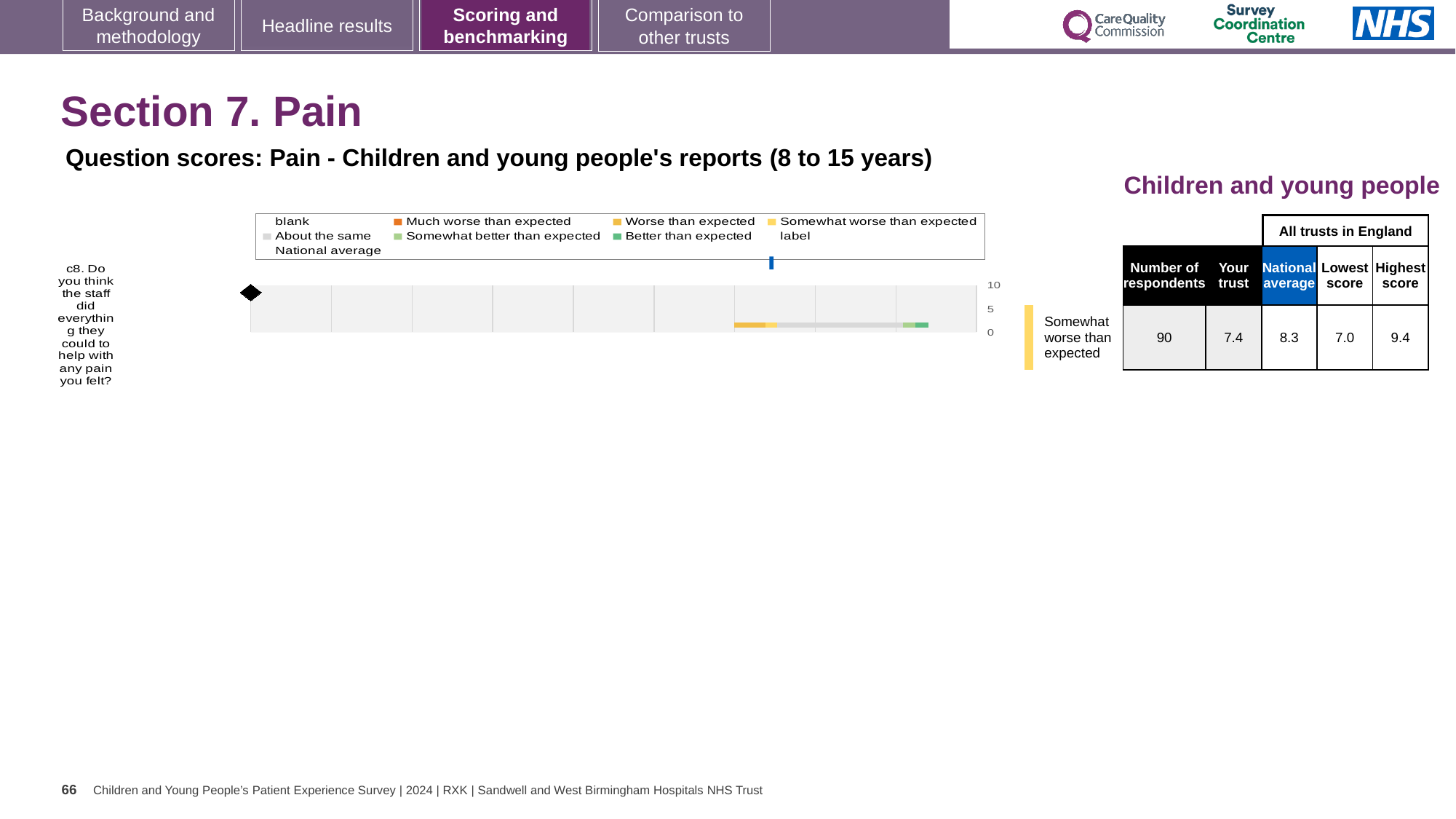
What kind of chart is used to show the question score for c8? bar chart In the table, how many respondents answered question c8? 90 What is the difference between the national average and the 'Your trust' score for question c8? 0.9 In the table, what is the national average score for question c8? 8.3 How many survey questions are plotted in the chart? 1 In the table, what is the lowest score among all trusts in England for question c8? 7.0 In the table, what is the 'Your trust' score for question c8? 7.4 Which is larger for question c8: the 'Your trust' score or the national average? National average Which question is plotted in the chart? c8. Do you think the staff did everything they could to help with any pain you felt? What is the difference between the highest score and the lowest score for question c8? 2.4 What benchmark category is shown for question c8? Somewhat worse than expected In the table, what is the highest score among all trusts in England for question c8? 9.4